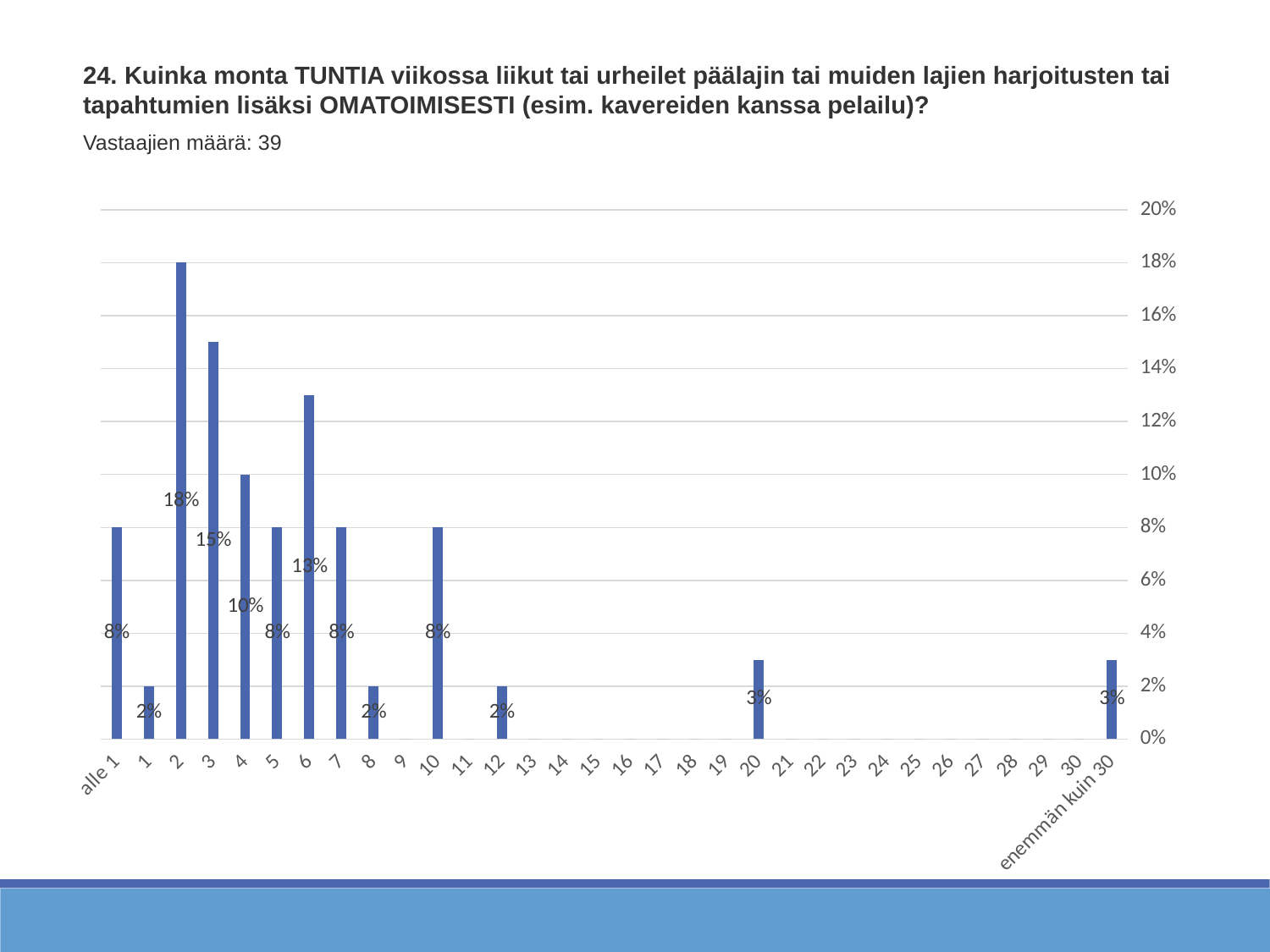
What kind of chart is shown on the slide? bar chart Is the value for category 2 greater or less than 16%? greater Which category has the highest value? 2 What is the difference between the values for category 2 and category 3? 3% What is the value for category 6? 13% What is the value for category 2? 18% Which is larger, the value for category 4 or the value for category 6? 6 What is the value for category 3? 15% What is the difference between the values for 'alle 1' and category 1? 6% What is the value for the category 'enemmän kuin 30'? 3% How many respondents does the slide report (Vastaajien määrä)? 39 What is the value for category 20? 3%